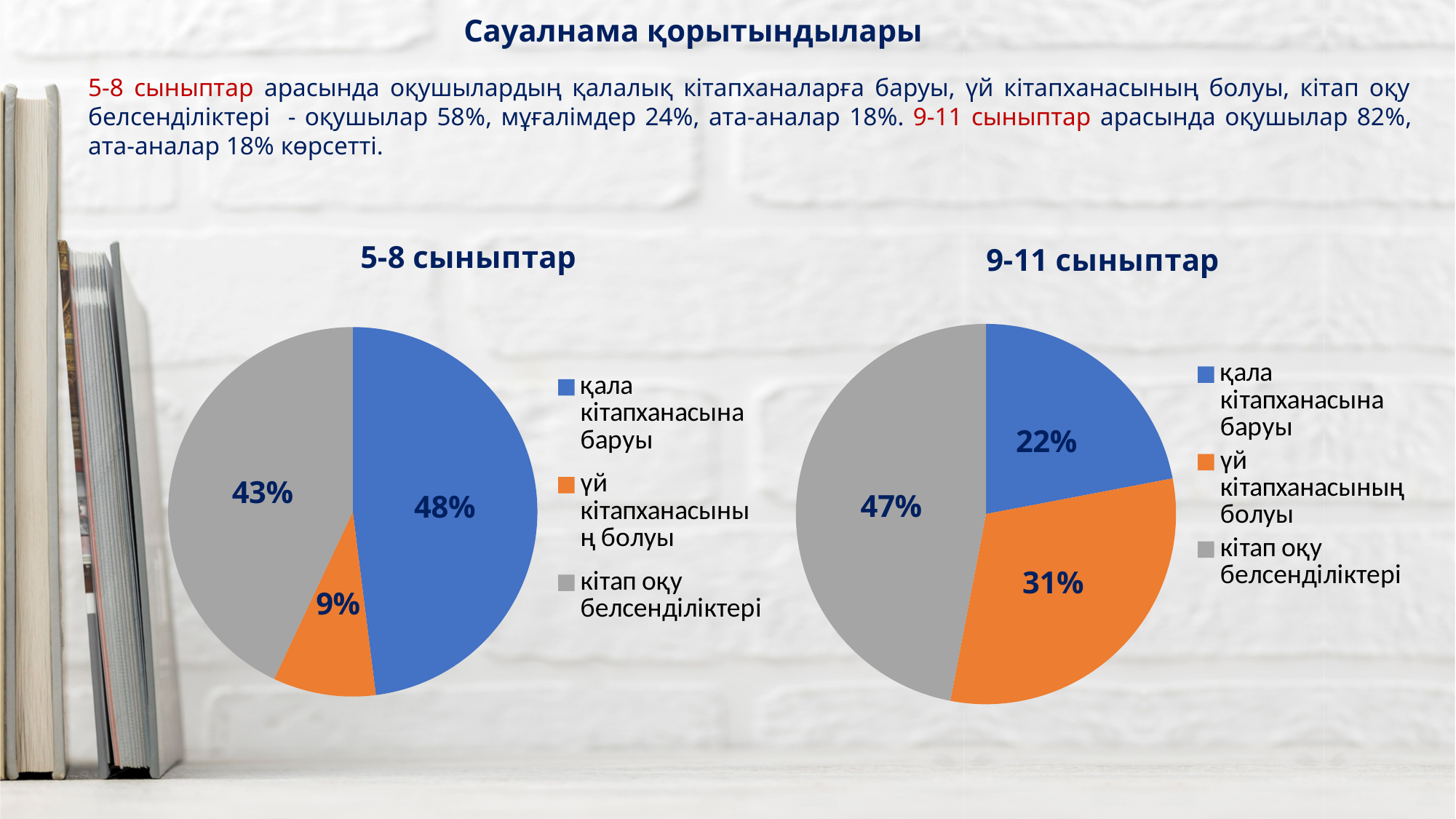
In the "5-8 сыныптар" chart, what is the difference between the shares for "кітап оқу белсенділіктері" and "үй кітапханасының болуы"? 34% In the "5-8 сыныптар" chart, what share is shown for "үй кітапханасының болуы"? 9% How many slices does the "9-11 сыныптар" chart have? 3 In the "5-8 сыныптар" chart, what share is shown for "қала кітапханасына баруы"? 48% In the "9-11 сыныптар" chart, which category has the smallest slice? қала кітапханасына баруы In the "5-8 сыныптар" chart, which category has the largest slice? қала кітапханасына баруы In the "9-11 сыныптар" chart, what share is shown for "үй кітапханасының болуы"? 31% In the "5-8 сыныптар" chart, which colour represents "кітап оқу белсенділіктері"? grey In the "9-11 сыныптар" chart, what share is shown for "кітап оқу белсенділіктері"? 47% In the "9-11 сыныптар" chart, what is the difference between the shares for "кітап оқу белсенділіктері" and "қала кітапханасына баруы"? 25% What type of chart is the "5-8 сыныптар" chart? pie chart Which chart shows a larger share for "үй кітапханасының болуы", "5-8 сыныптар" or "9-11 сыныптар"? 9-11 сыныптар